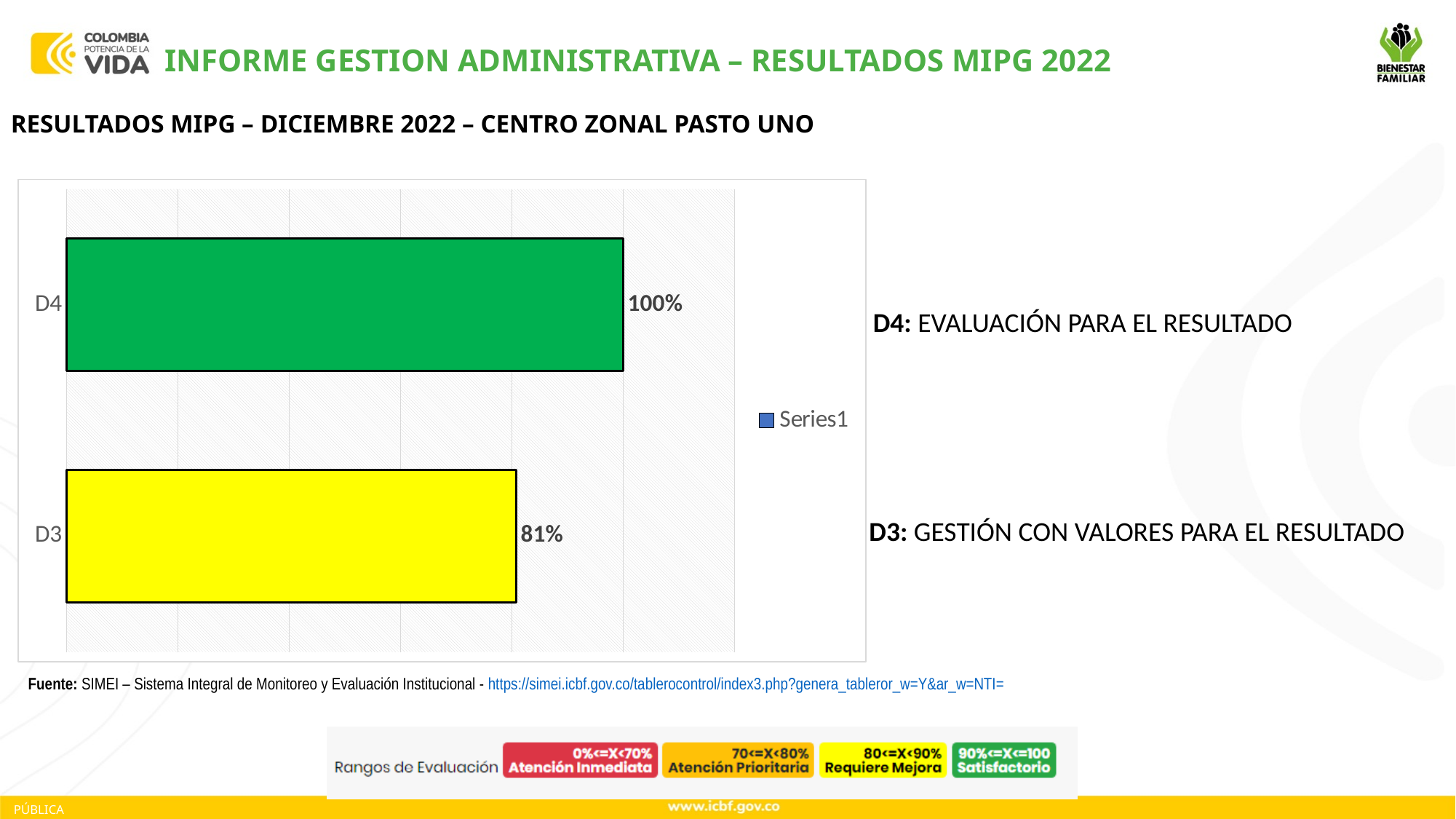
How many categories are plotted in the chart? 2 Which category has the lowest value? D3 Which category has the highest value? D4 What kind of chart is shown on the slide? Bar chart What colour is the bar for D3? Yellow How many series does the legend list? 1 What is the value for D4? 100% Which is larger, the value for D4 or the value for D3? D4 What is the difference between the values for D4 and D3? 19% What is the name of the series listed in the legend? Series1 What is the value for D3? 81%